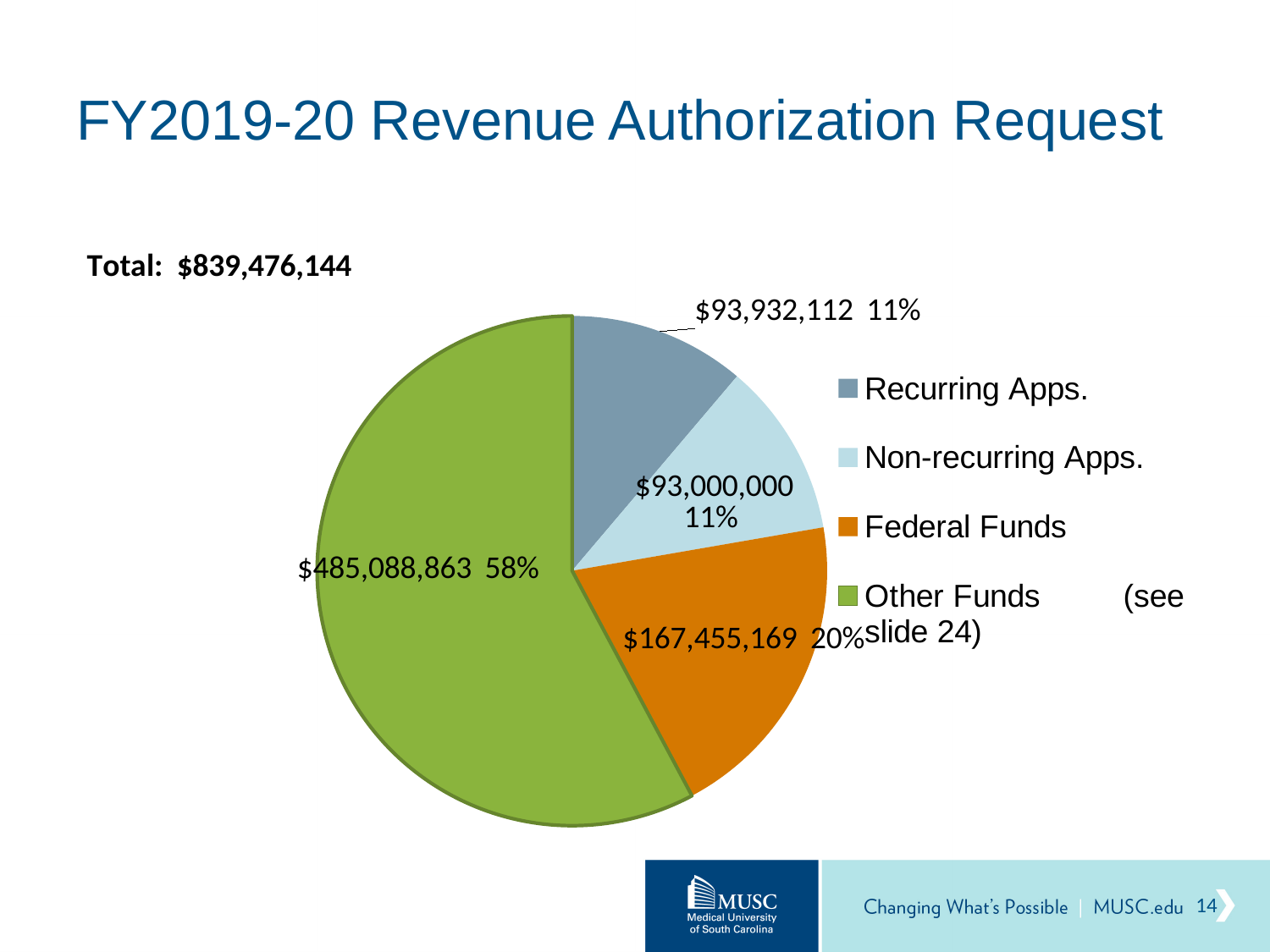
What share of the pie does Federal Funds represent? 20% What is the value for Federal Funds? $167,455,169 How many categories does the pie chart have? 4 Which is larger, Federal Funds or Non-recurring Apps.? Federal Funds What is the difference between the Other Funds value and the Federal Funds value? $317,633,694 What total is stated on the slide for the revenue authorization request? $839,476,144 What is the value for Other Funds? $485,088,863 What type of chart is shown on the slide? Pie chart What share of the pie does Other Funds represent? 58% What is the value for Recurring Apps.? $93,932,112 Which category has the largest slice of the pie? Other Funds What is the value for Non-recurring Apps.? $93,000,000